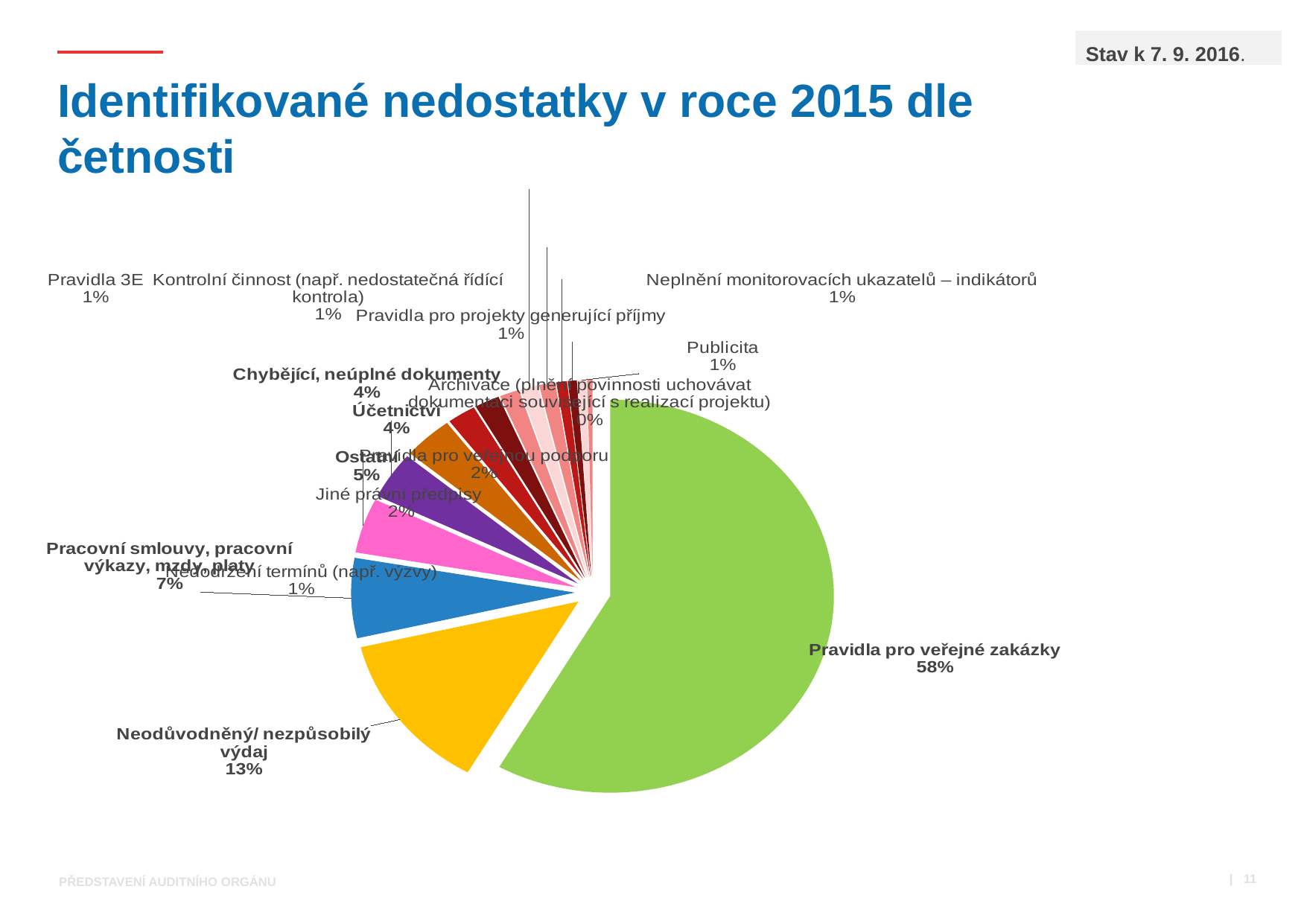
Which category has the largest slice of the pie? Pravidla pro veřejné zakázky What is the difference between the shares of "Pravidla pro veřejné zakázky" and "Neodůvodněný/ nezpůsobilý výdaj"? 45% What is the title of the chart on the slide? Identifikované nedostatky v roce 2015 dle četnosti What share of the pie does "Pravidla pro veřejné zakázky" have? 58% What is the value shown for "Jiné právní předpisy"? 2% What is the value shown for "Pracovní smlouvy, pracovní výkazy, mzdy, platy"? 7% Which is larger, the share for "Pracovní smlouvy, pracovní výkazy, mzdy, platy" or the share for "Ostatní"? Pracovní smlouvy, pracovní výkazy, mzdy, platy What kind of chart is shown on the slide? pie chart What is the value shown for "Publicita"? 1% What is the value shown for "Ostatní"? 5% What is the value shown for "Účetnictví"? 4% What share of the pie does "Neodůvodněný/ nezpůsobilý výdaj" have? 13%